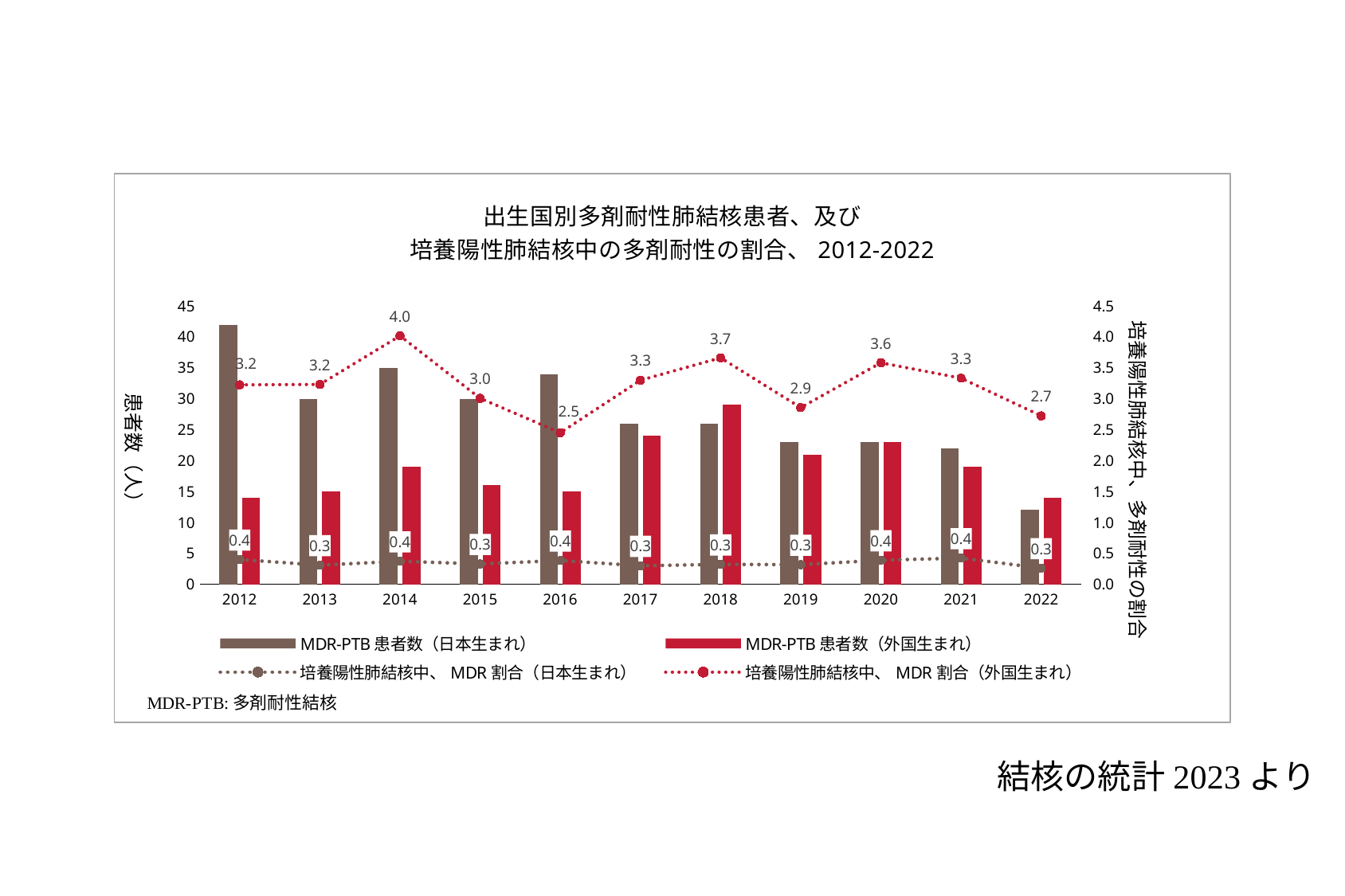
How many series does the legend list? 4 What is the MDR ratio among culture-positive pulmonary TB for foreign-born patients (培養陽性肺結核中、MDR割合（外国生まれ）) in 2014? 4.0 What is the MDR ratio for Japan-born patients (日本生まれ) in 2013? 0.3 Does the number of Japan-born MDR-PTB patients (日本生まれ) generally rise or fall from 2012 to 2022? fall What is the MDR ratio for foreign-born patients (外国生まれ) in 2022? 2.7 In which year is the MDR ratio for foreign-born patients (外国生まれ) the lowest? 2016 Is the number of foreign-born MDR-PTB patients (外国生まれ) in 2018 greater or less than 25? greater What is the difference between the foreign-born MDR ratio in 2014 and in 2016? 1.5 Which year has a higher foreign-born MDR ratio, 2018 or 2020? 2018 How many years are shown on the x axis of the chart? 11 In which year is the MDR ratio for foreign-born patients (外国生まれ) the highest? 2014 Is the number of Japan-born MDR-PTB patients (日本生まれ) in 2012 greater or less than 40? greater